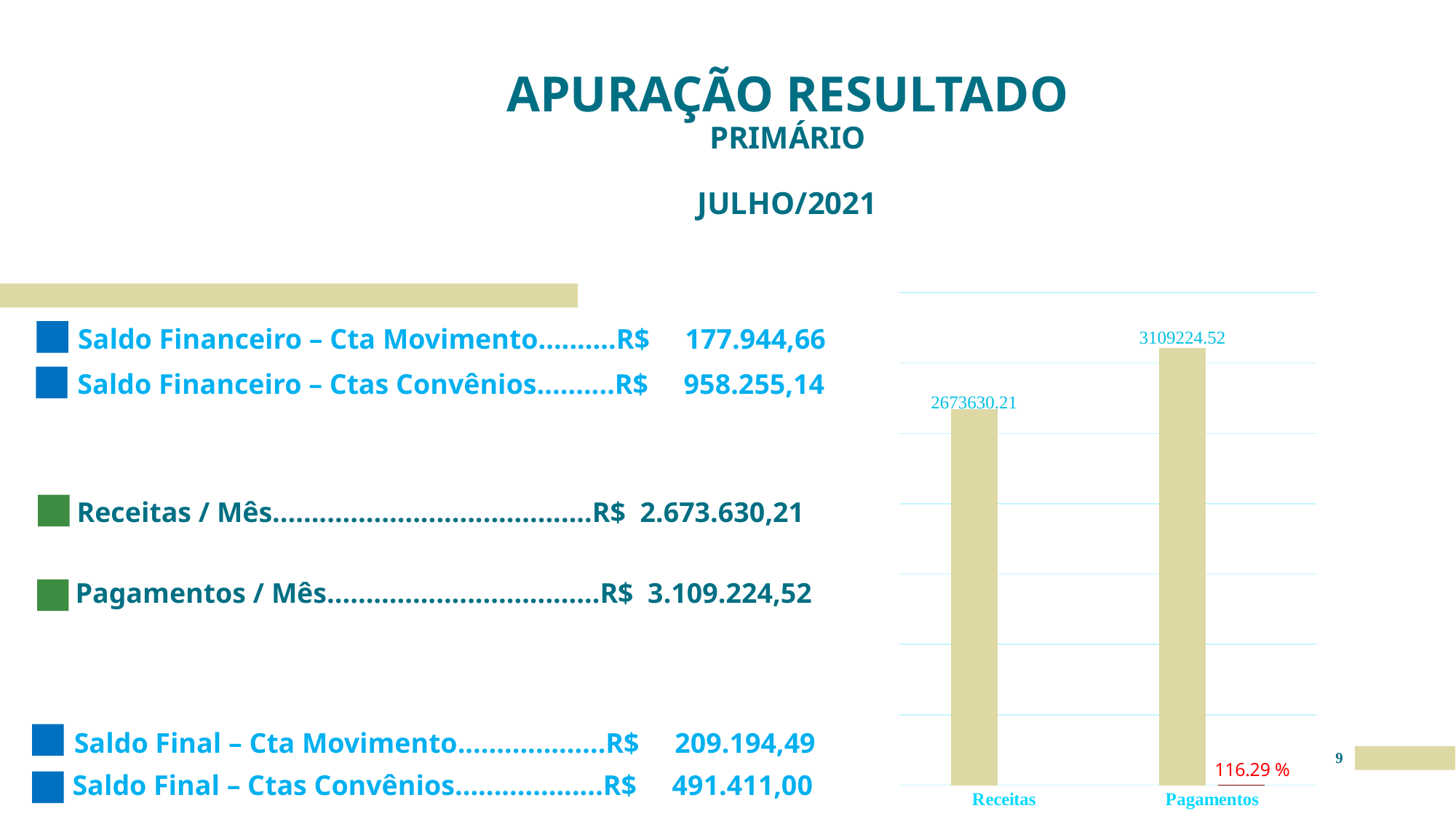
Which is larger in the chart, Receitas or Pagamentos? Pagamentos What is the value of the Receitas bar in the chart? 2673630.21 What is the value of the Pagamentos bar in the chart? 3109224.52 Which category has the lowest bar in the chart? Receitas How many bars are plotted in the chart? 2 What is the difference between the Pagamentos and Receitas values in the chart? 435594.31 What percentage is printed in red near the bottom of the Pagamentos bar? 116.29 % What type of chart is shown on the slide? Bar chart What are the category labels on the x axis of the chart? Receitas, Pagamentos Do the bar values rise or fall from Receitas to Pagamentos? Rise Which category has the highest bar in the chart? Pagamentos